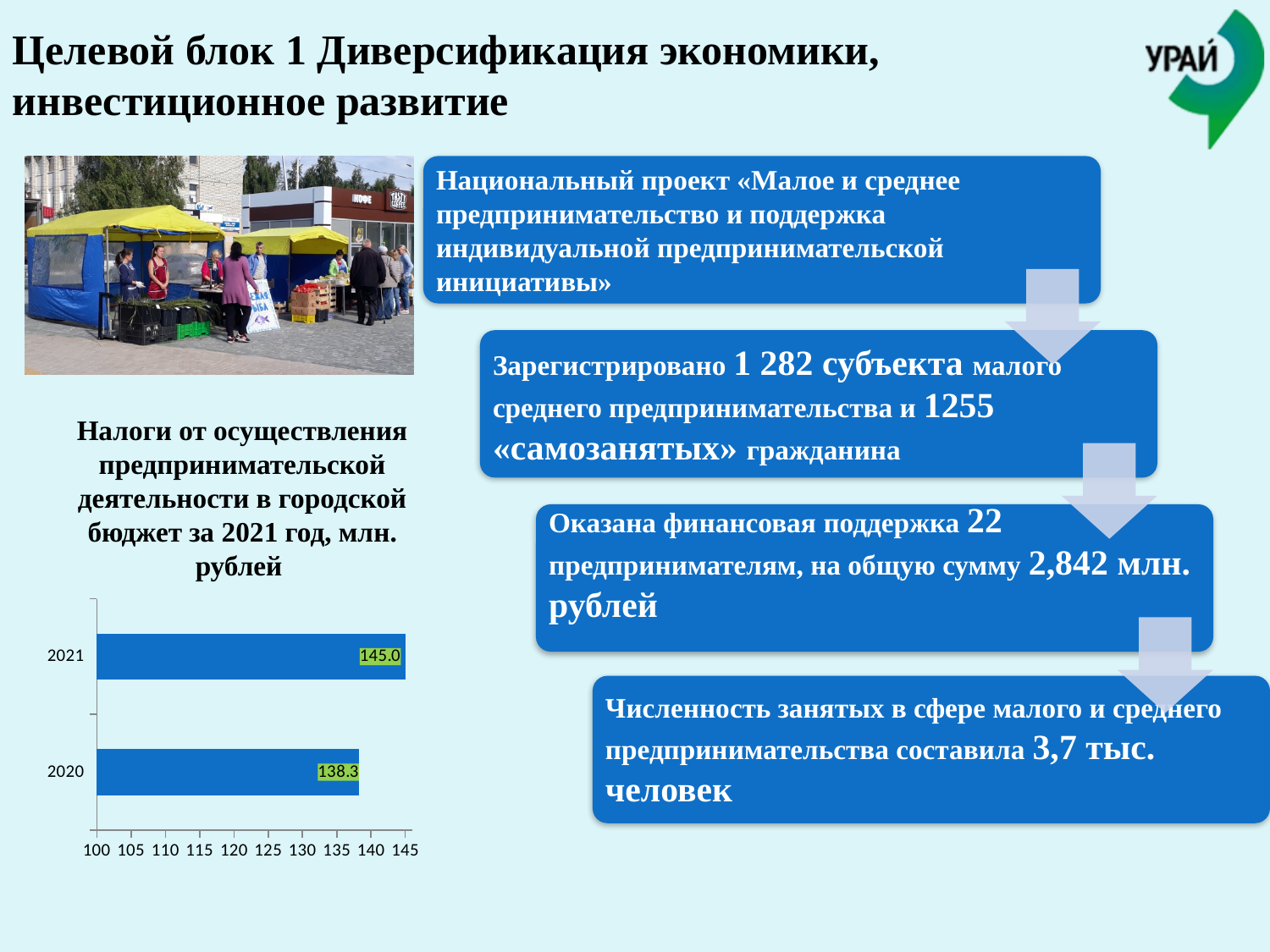
Which year has the higher value in the bar chart? 2021 What is the difference between the 2021 and 2020 values in the bar chart? 6.7 Is the value for 2020 larger or smaller than the value for 2021? smaller What is the value for 2021 in the bar chart? 145.0 What kind of chart is shown on the slide? bar chart What is the lowest value shown on the x axis of the bar chart? 100 What is the title of the bar chart? Налоги от осуществления предпринимательской деятельности в городской бюджет за 2021 год, млн. рублей How many years are shown in the bar chart? 2 Is the value for 2020 greater or less than 140? less Which year has the lower value in the bar chart? 2020 What is the value for 2020 in the bar chart? 138.3 Do the values in the bar chart rise or fall from 2020 to 2021? rise